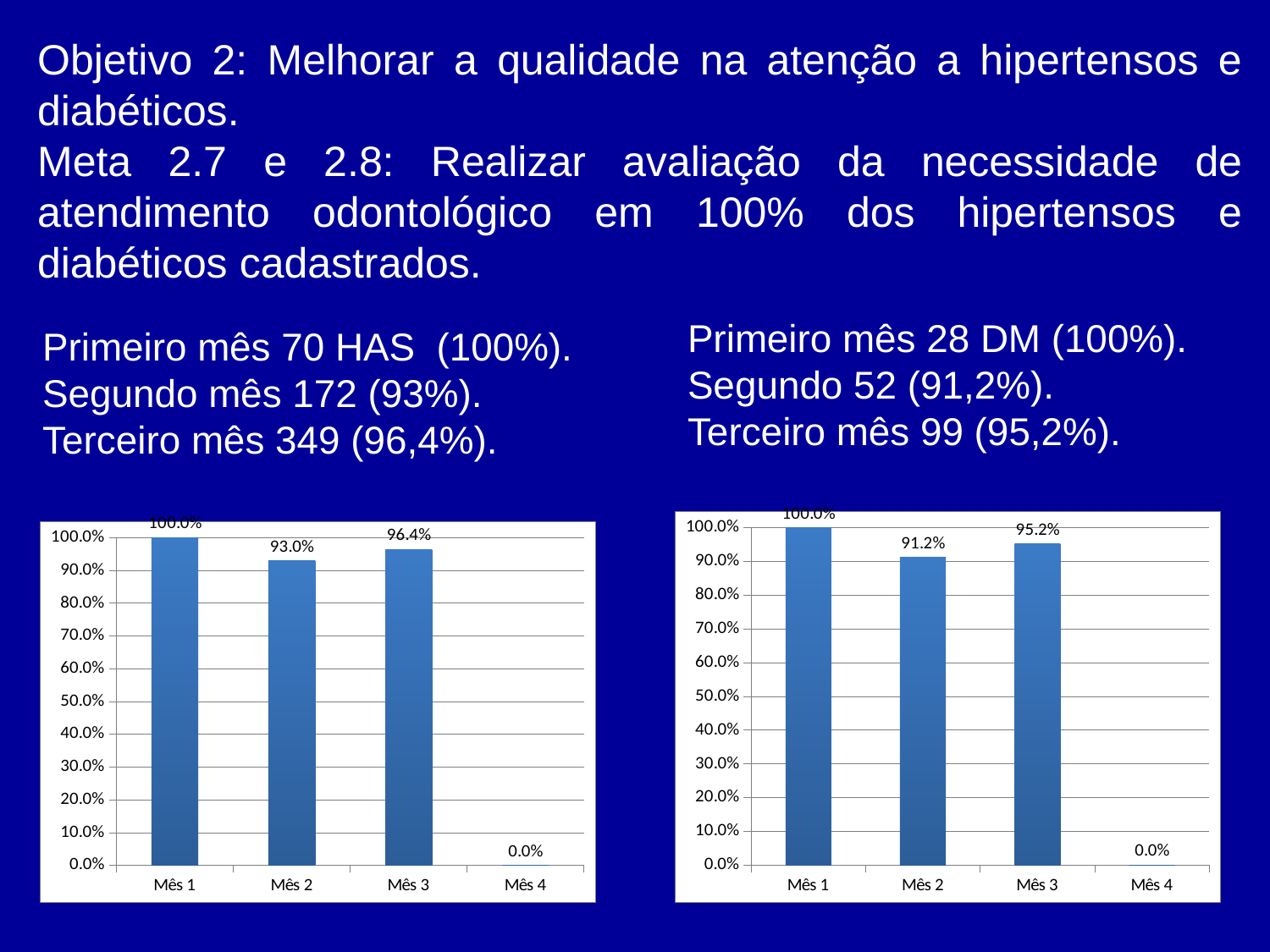
In the left chart, what is the value for Mês 2? 93.0% In the left chart, what is the value for Mês 3? 96.4% What type of chart is the right chart? Bar chart How many months are shown on the x axis of the left chart? 4 In the left chart, which month has the highest value? Mês 1 In the right chart, which month has the lowest value? Mês 4 In the left chart, what is the difference between the values for Mês 3 and Mês 2? 3.4% In the right chart, what is the value for Mês 3? 95.2% In the right chart, what is the value for Mês 2? 91.2% In the right chart, which is larger, the value for Mês 2 or Mês 3? Mês 3 In the right chart, what is the difference between the values for Mês 1 and Mês 2? 8.8% In the right chart, what is the value for Mês 4? 0.0%